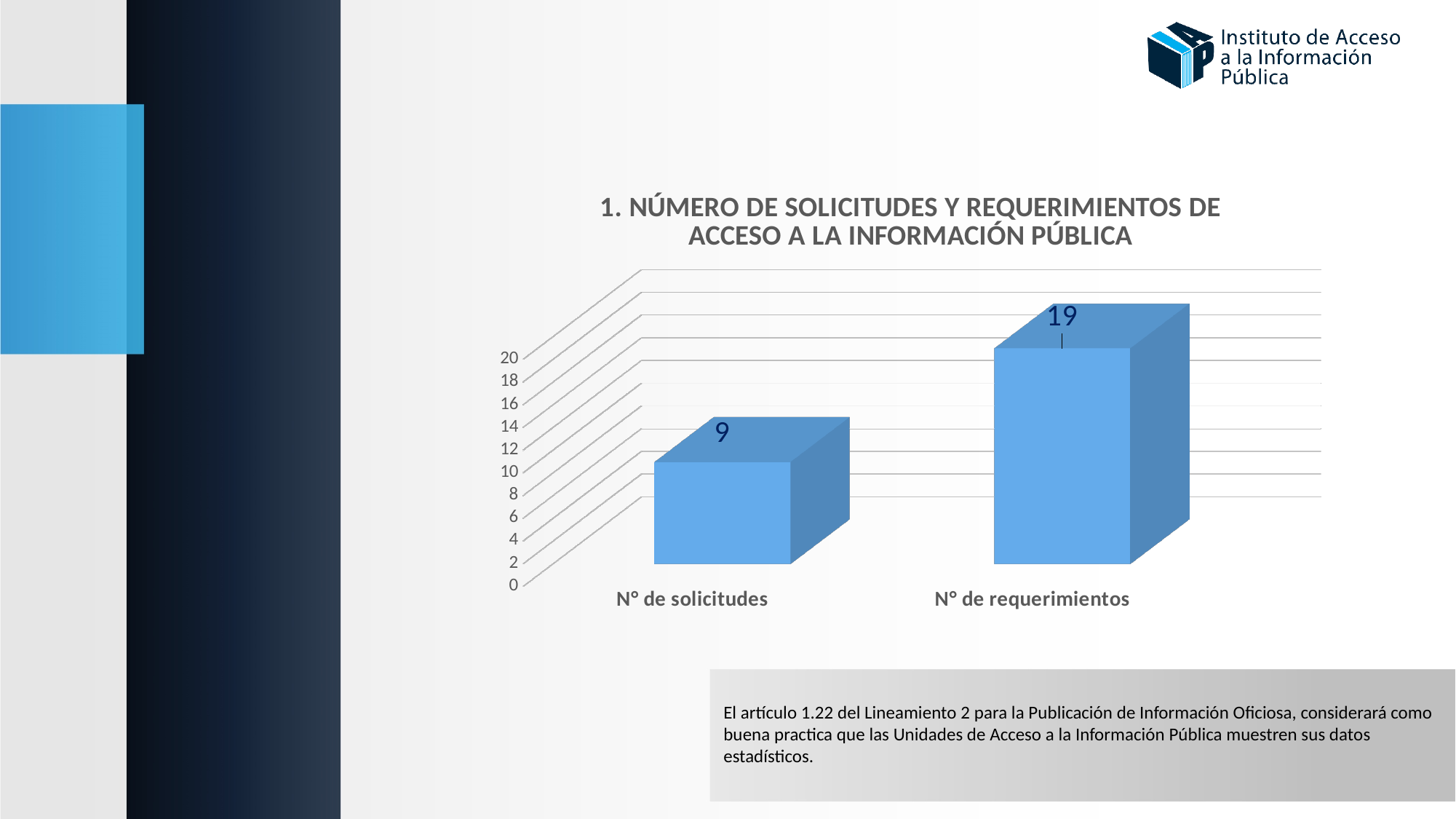
Which is larger, N° de solicitudes or N° de requerimientos? N° de requerimientos Is the value for N° de solicitudes greater or less than 10? less Which category has the highest value? N° de requerimientos Is the value for N° de requerimientos greater or less than 10? greater What is the value for N° de solicitudes? 9 What is the value for N° de requerimientos? 19 Which category has the lowest value? N° de solicitudes What is the difference between N° de requerimientos and N° de solicitudes? 10 What kind of chart is shown on the slide? bar chart How many categories are shown in the chart? 2 What is the maximum value shown on the vertical axis? 20 What is the title of the chart? 1. NÚMERO DE SOLICITUDES Y REQUERIMIENTOS DE ACCESO A LA INFORMACIÓN PÚBLICA